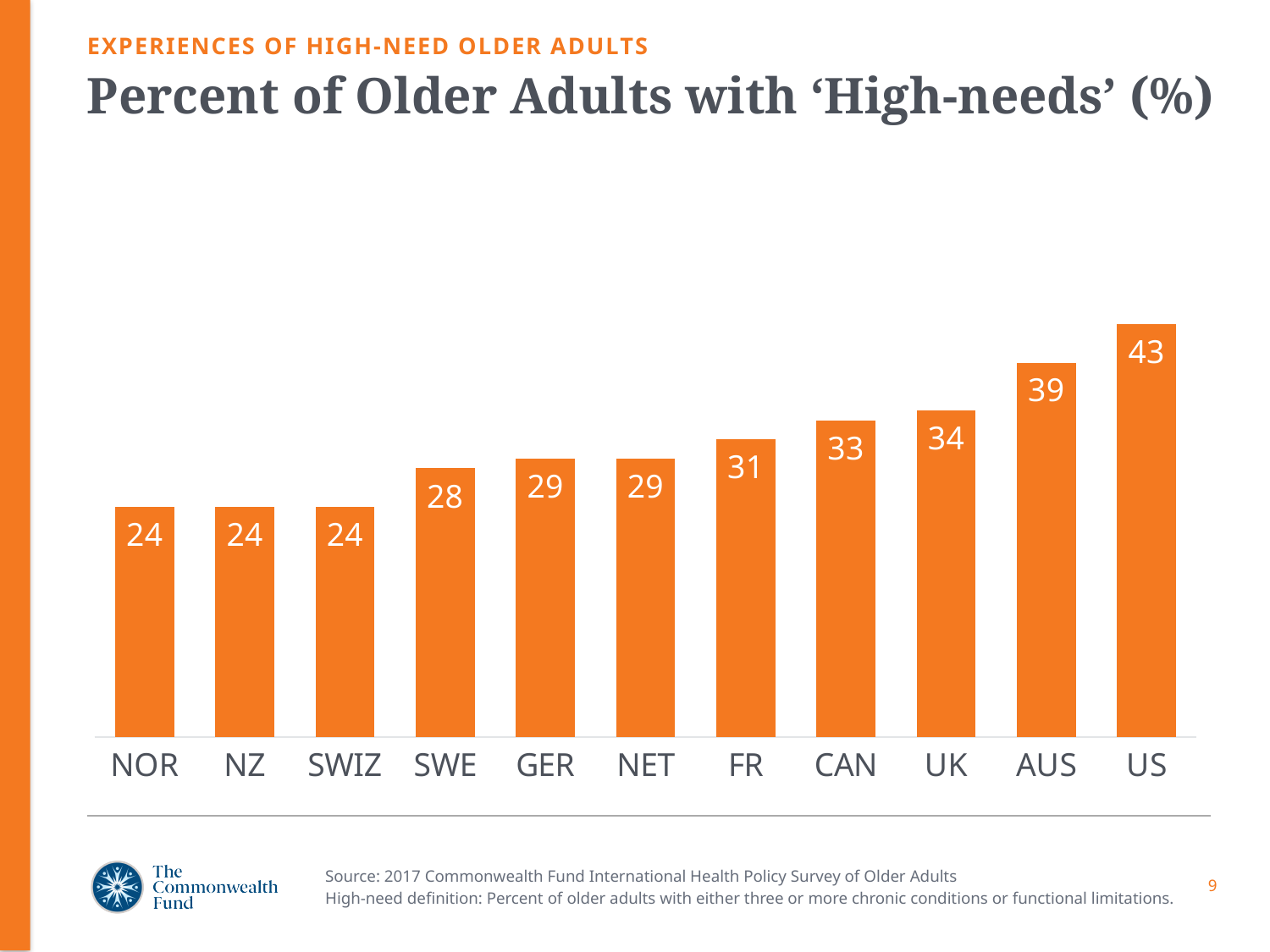
What kind of chart is this? Bar chart Do the values rise or fall from left to right along the x axis? Rise How many countries have a value of 24? 3 Which country has the highest value? US What is the value for the US? 43 How many countries are shown on the chart? 11 What is the value for CAN? 33 What is the difference between the values for the US and NOR? 19 What is the title of the chart? Percent of Older Adults with 'High-needs' (%) Which is larger, the value for FR or the value for GER? FR What is the value for SWE? 28 What is the difference between the values for AUS and UK? 5